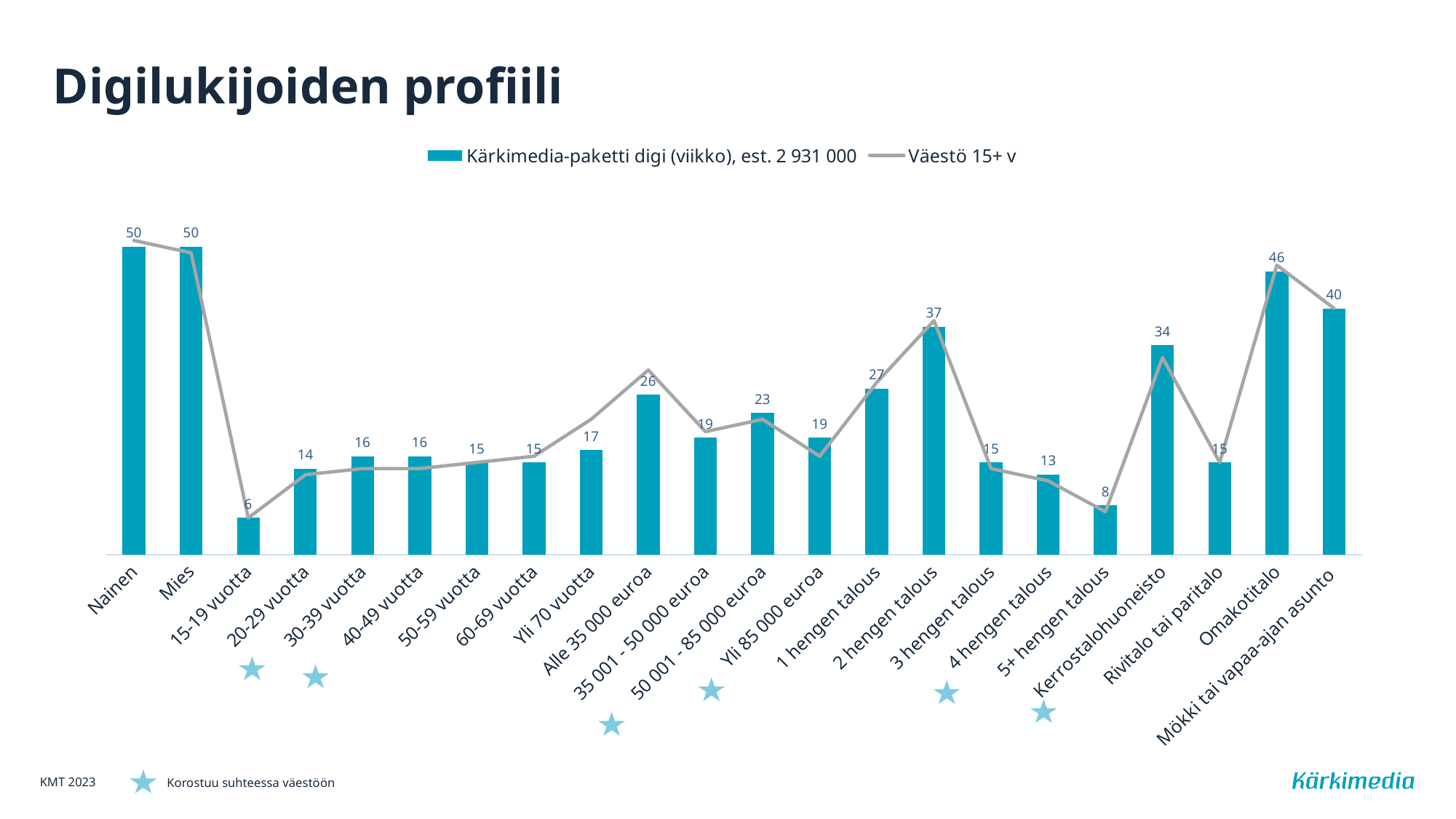
Which category has the lowest bar value for Kärkimedia-paketti digi (viikko)? 15-19 vuotta What kind of chart is shown on the slide? Bar chart with a line Which has a higher bar value, Kerrostalohuoneisto or Rivitalo tai paritalo? Kerrostalohuoneisto What is the difference between the bar values for Alle 35 000 euroa and Yli 85 000 euroa? 7 What is the value for Kärkimedia-paketti digi (viikko) for 15-19 vuotta? 6 What is the value for Kärkimedia-paketti digi (viikko) for Kerrostalohuoneisto? 34 Which has a higher bar value, 1 hengen talous or 5+ hengen talous? 1 hengen talous What is the value for Kärkimedia-paketti digi (viikko) for 2 hengen talous? 37 How many categories are shown on the x axis of the chart? 22 What is the value for Kärkimedia-paketti digi (viikko) for Omakotitalo? 46 How many series does the legend list? 2 What is the difference between the bar values for Omakotitalo and Mökki tai vapaa-ajan asunto? 6